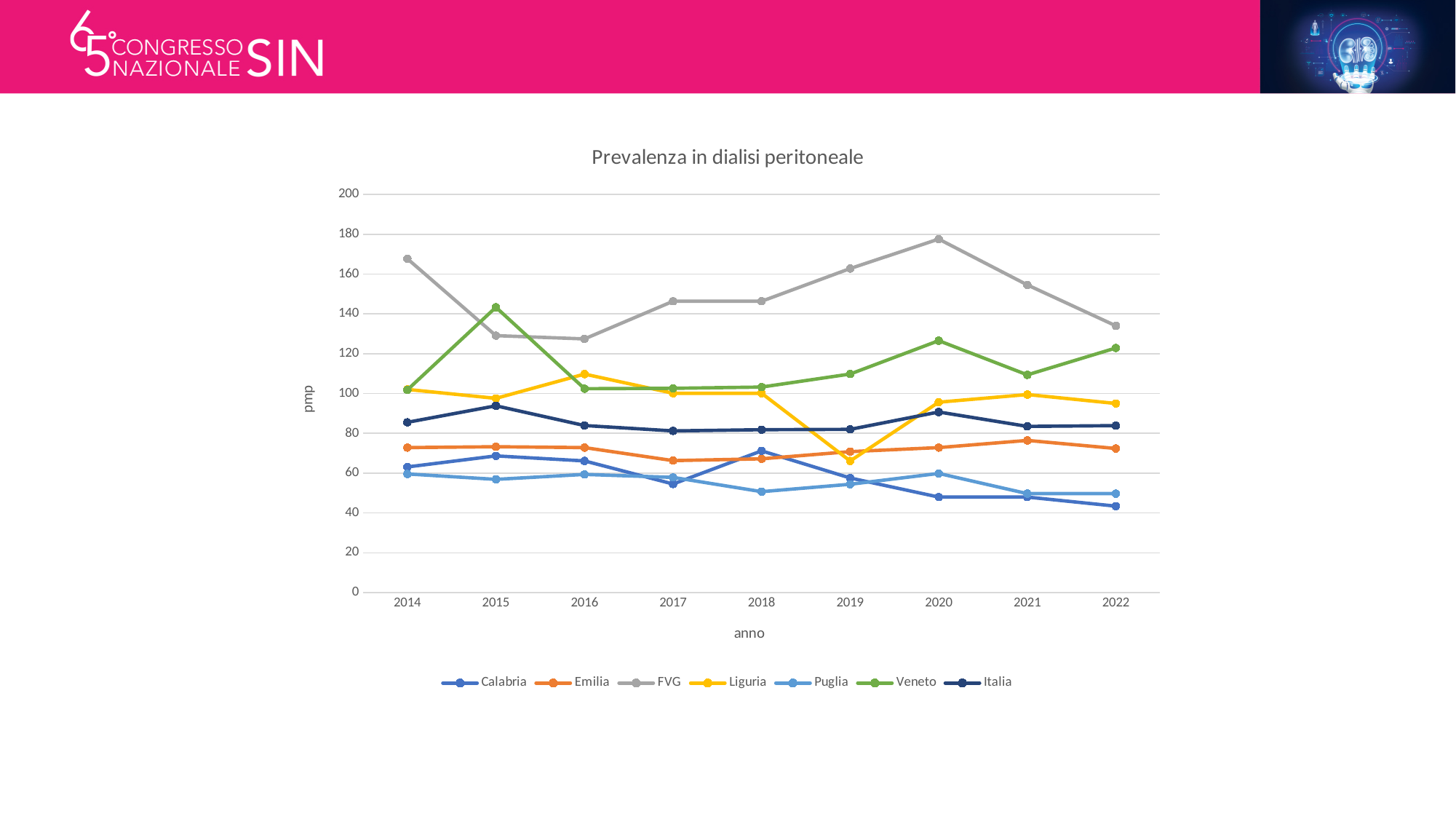
What kind of chart is shown on the slide? line chart How many series does the legend list? 7 How many years are plotted along the x axis? 9 Is the value for Calabria in 2022 greater or less than 60? less In which year does FVG reach its highest value? 2020 Which series has the lowest value in 2022? Calabria In 2015, which is larger: the value for Veneto or the value for Liguria? Veneto Is the value for FVG in 2020 greater or less than 160? greater Which series has the highest value in 2020? FVG Does the value for Calabria rise or fall from 2018 to 2022? fall What is the label on the y axis? pmp Is the value for Veneto in 2015 greater or less than 120? greater